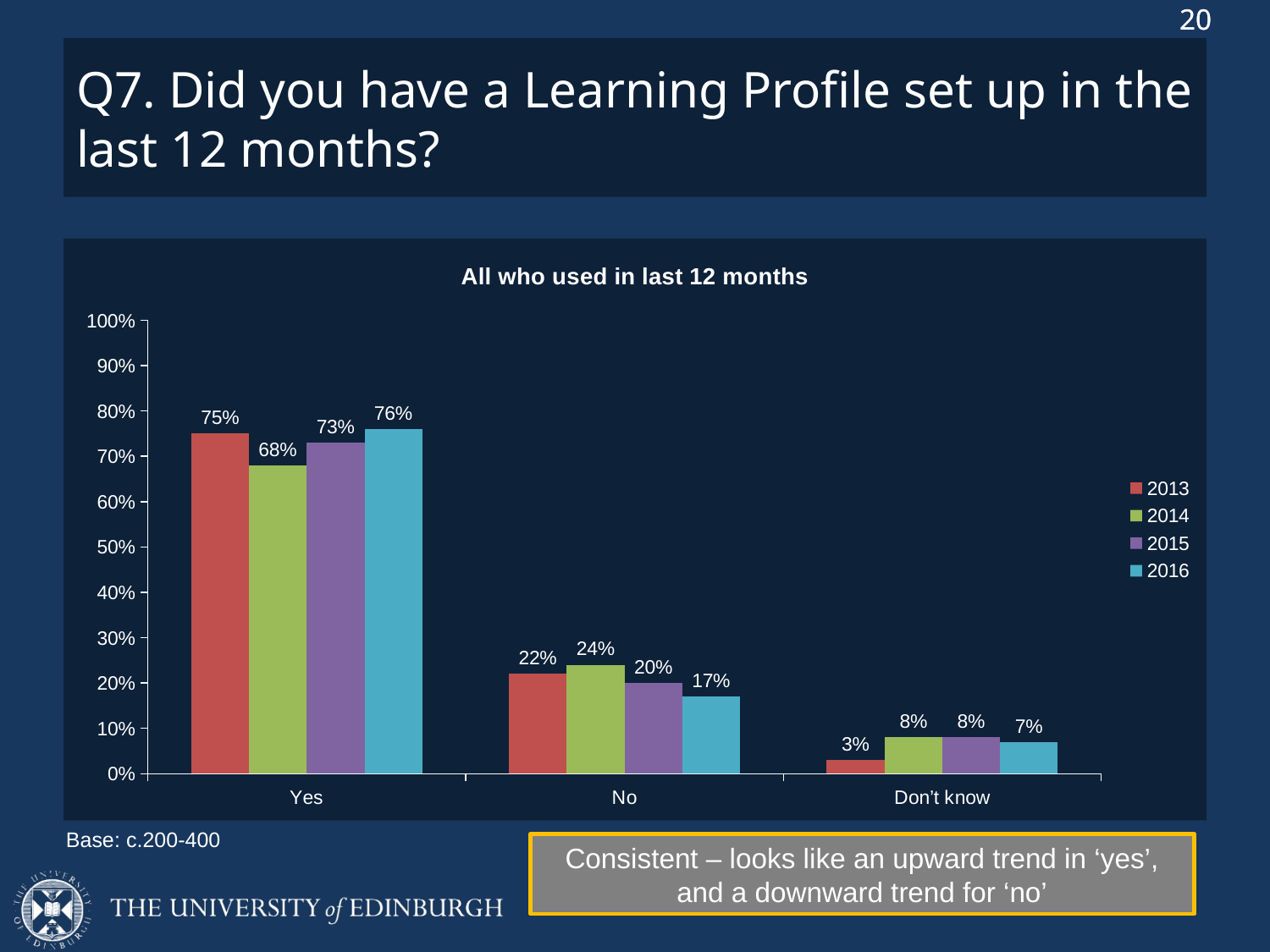
Which year has the lowest value in the Yes category? 2014 What is the value for 2016 in the Yes category? 76% What is the title of the chart? All who used in last 12 months How many series does the legend list? 4 What is the difference between the 2013 and 2016 values in the No category? 5% What is the value for 2014 in the No category? 24% What kind of chart is shown on the slide? Bar chart What is the value for 2013 in the Don't know category? 3% Which year has the highest value in the No category? 2014 What is the difference between the 2013 and 2014 values in the Yes category? 7% How many categories are shown on the x axis? 3 Which is larger: the 2015 value for Yes or the 2013 value for Yes? 2013 value for Yes